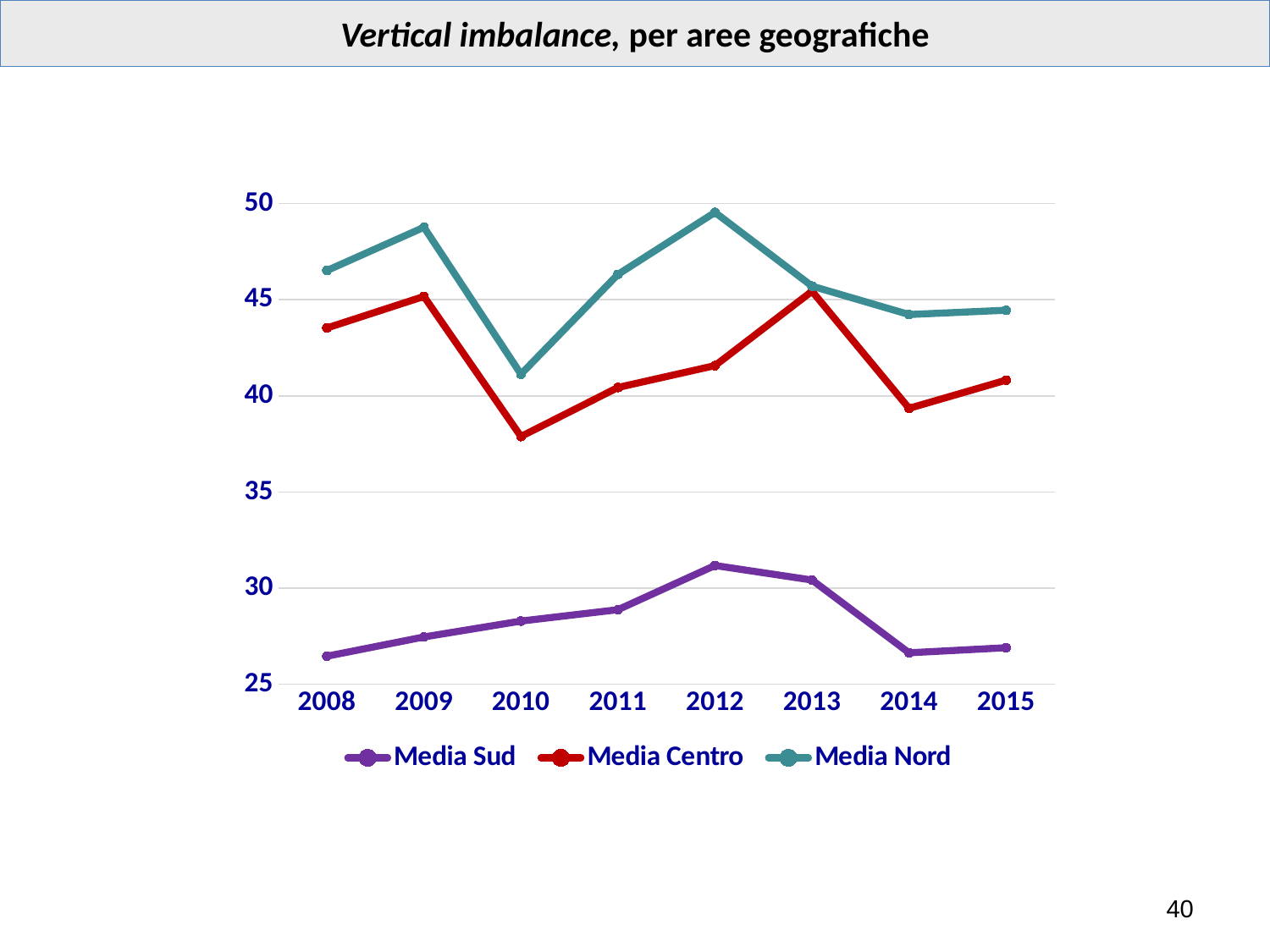
What kind of chart is shown on the slide? line chart Is the value for Media Nord in 2012 greater or less than 45? greater In which year does Media Centro reach its lowest value? 2010 Is the value for Media Centro in 2010 greater or less than 40? less In which year does Media Nord reach its lowest value? 2010 Does Media Sud rise or fall from 2008 to 2012? rise Which series has the lowest values across all years? Media Sud How many years are plotted along the x axis? 8 What is the title of the chart? Vertical imbalance, per aree geografiche Is the value for Media Sud in 2012 greater or less than 30? greater How many series does the legend list? 3 Which is larger for Media Sud: the value in 2012 or the value in 2008? 2012